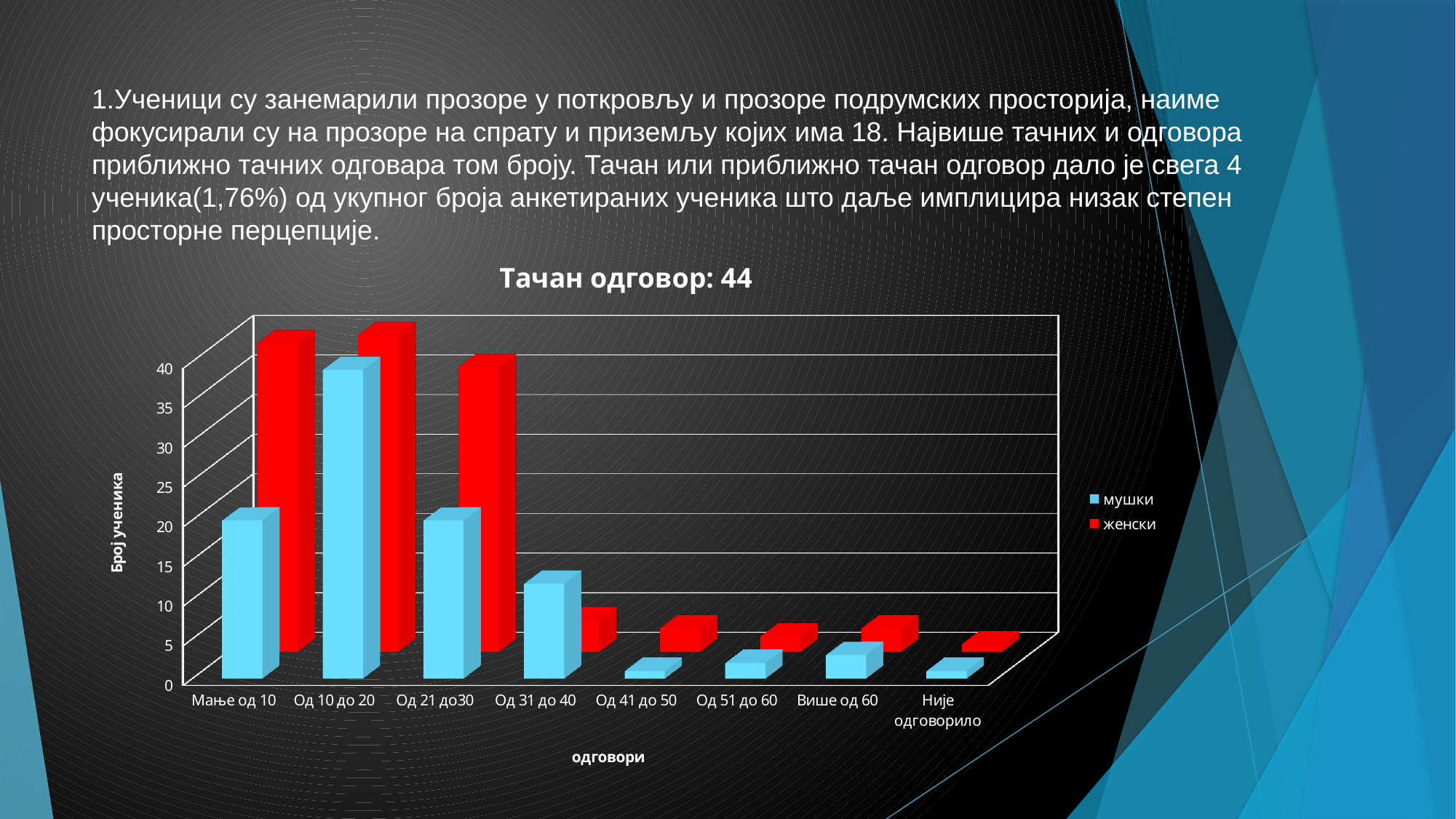
What type of chart is shown on the slide? bar chart How many categories are shown on the x axis? 8 Which category has the highest value for the мушки series? Од 10 до 20 What is the title of the chart? Тачан одговор: 44 What is the label of the vertical axis? Број ученика Is the value for женски in the category Од 31 до 40 greater or less than 15? less For the category Мање од 10, which series has the larger value, мушки or женски? женски Is the value for женски in the category Од 21 до30 greater or less than 30? greater How many series does the legend list? 2 Is the value for мушки in the category Мање од 10 greater or less than 30? less